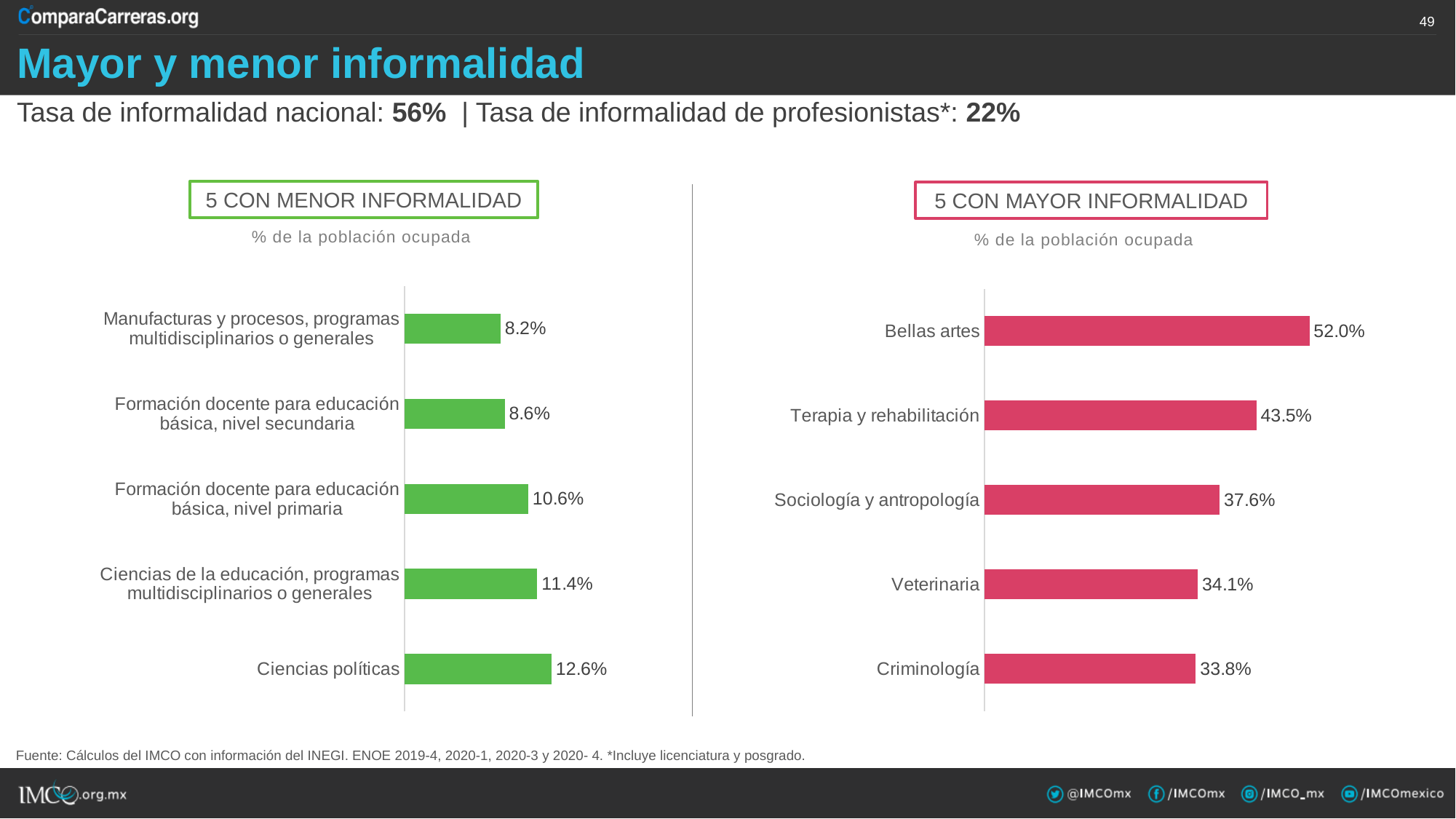
What colour are the bars in the '5 CON MAYOR INFORMALIDAD' chart? Pink/red In the '5 CON MAYOR INFORMALIDAD' chart, what is the value for Veterinaria? 34.1% In the '5 CON MAYOR INFORMALIDAD' chart, what is the difference between Bellas artes and Terapia y rehabilitación? 8.5% In the '5 CON MAYOR INFORMALIDAD' chart, which is larger: Sociología y antropología or Criminología? Sociología y antropología How many categories are shown in the '5 CON MENOR INFORMALIDAD' chart? 5 What kind of chart is the '5 CON MAYOR INFORMALIDAD' chart? Bar chart In the '5 CON MENOR INFORMALIDAD' chart, what is the value for Ciencias políticas? 12.6% In the '5 CON MAYOR INFORMALIDAD' chart, which category has the highest value? Bellas artes In the '5 CON MENOR INFORMALIDAD' chart, which category has the lowest value? Manufacturas y procesos, programas multidisciplinarios o generales In the '5 CON MENOR INFORMALIDAD' chart, what is the difference between Ciencias políticas and Formación docente para educación básica, nivel secundaria? 4.0% What unit is indicated under the title of the '5 CON MENOR INFORMALIDAD' chart? % de la población ocupada